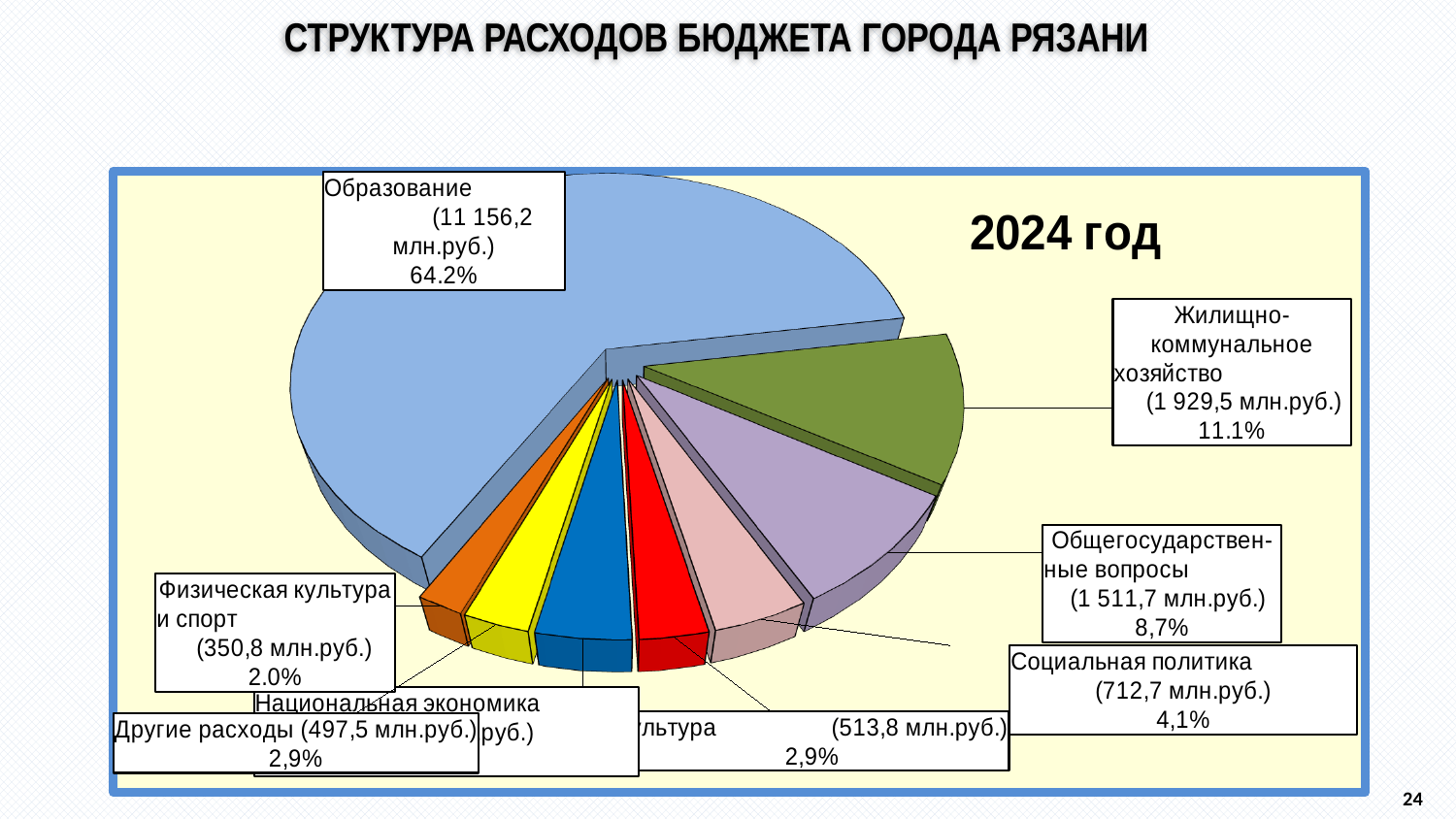
What is the amount for Общегосударственные вопросы? 1 511,7 млн.руб. What share of expenditures is Жилищно-коммунальное хозяйство? 11.1% Which category has the largest share of the budget expenditures? Образование What type of chart is shown on the slide? pie chart Which year does the chart show data for? 2024 год What is the amount for Физическая культура и спорт? 350,8 млн.руб. What share of the budget expenditures goes to Образование? 64.2% What share of expenditures is Социальная политика? 4,1% What is the amount for Другие расходы? 497,5 млн.руб. Which is larger: the share for Жилищно-коммунальное хозяйство or for Общегосударственные вопросы? Жилищно-коммунальное хозяйство What is the difference in percentage points between the shares of Жилищно-коммунальное хозяйство and Общегосударственные вопросы? 2.4 What is the amount in млн.руб. for Образование? 11 156,2 млн.руб.